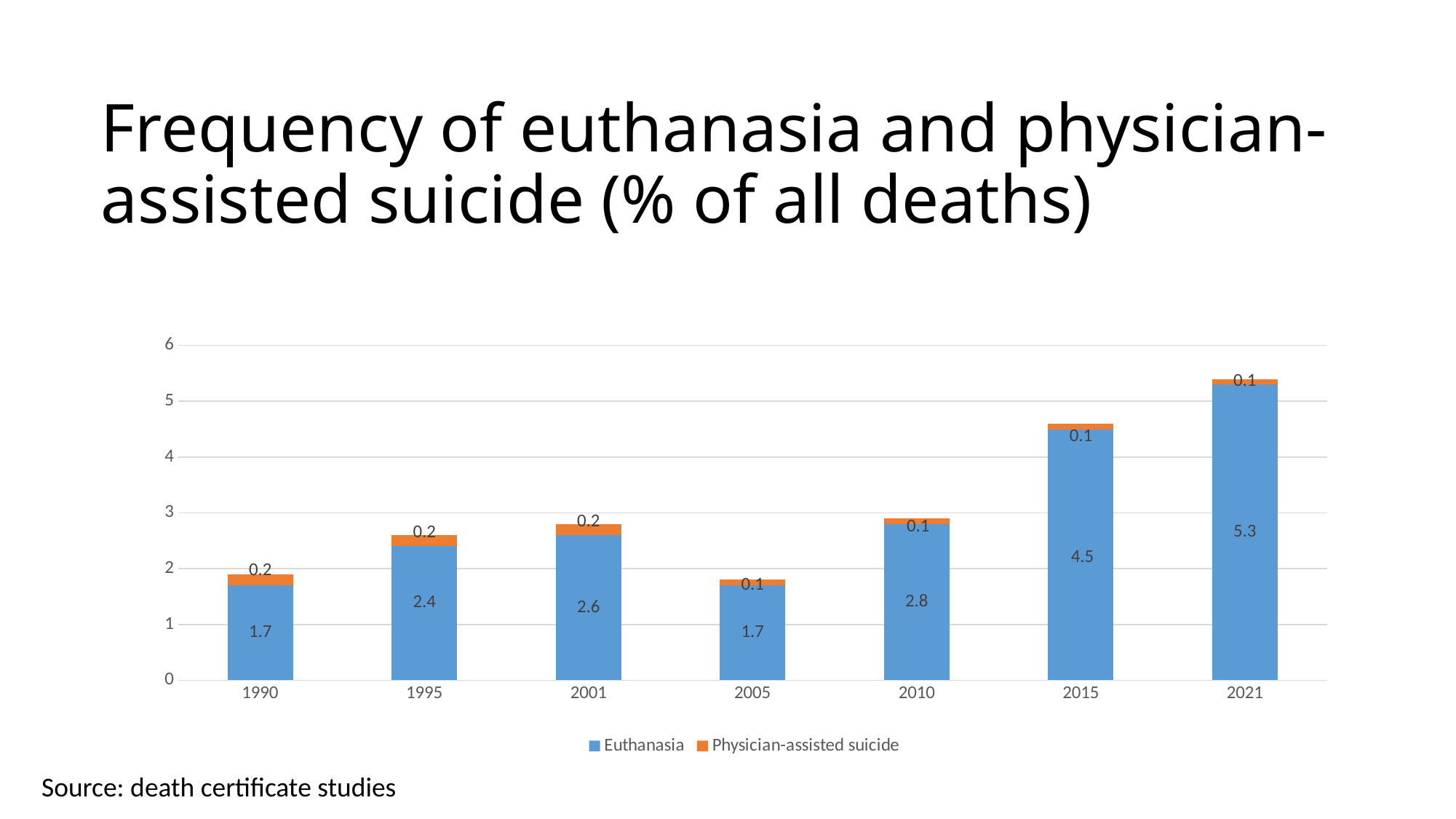
Which year has the lowest total stacked bar? 2005 What is the total of the stacked bar for 1990? 1.9 What is the Euthanasia value for 2005? 1.7 Which is larger, the Euthanasia value for 2001 or for 2010? 2010 What is the Euthanasia value for 2021? 5.3 What is the Physician-assisted suicide value for 1995? 0.2 What kind of chart is shown on the slide? Stacked bar chart What is the difference between the Euthanasia values for 2021 and 2015? 0.8 How many years are shown on the x axis? 7 How many series does the legend list? 2 Which year has the highest Euthanasia value? 2021 What is the total of the stacked bar for 2015? 4.6